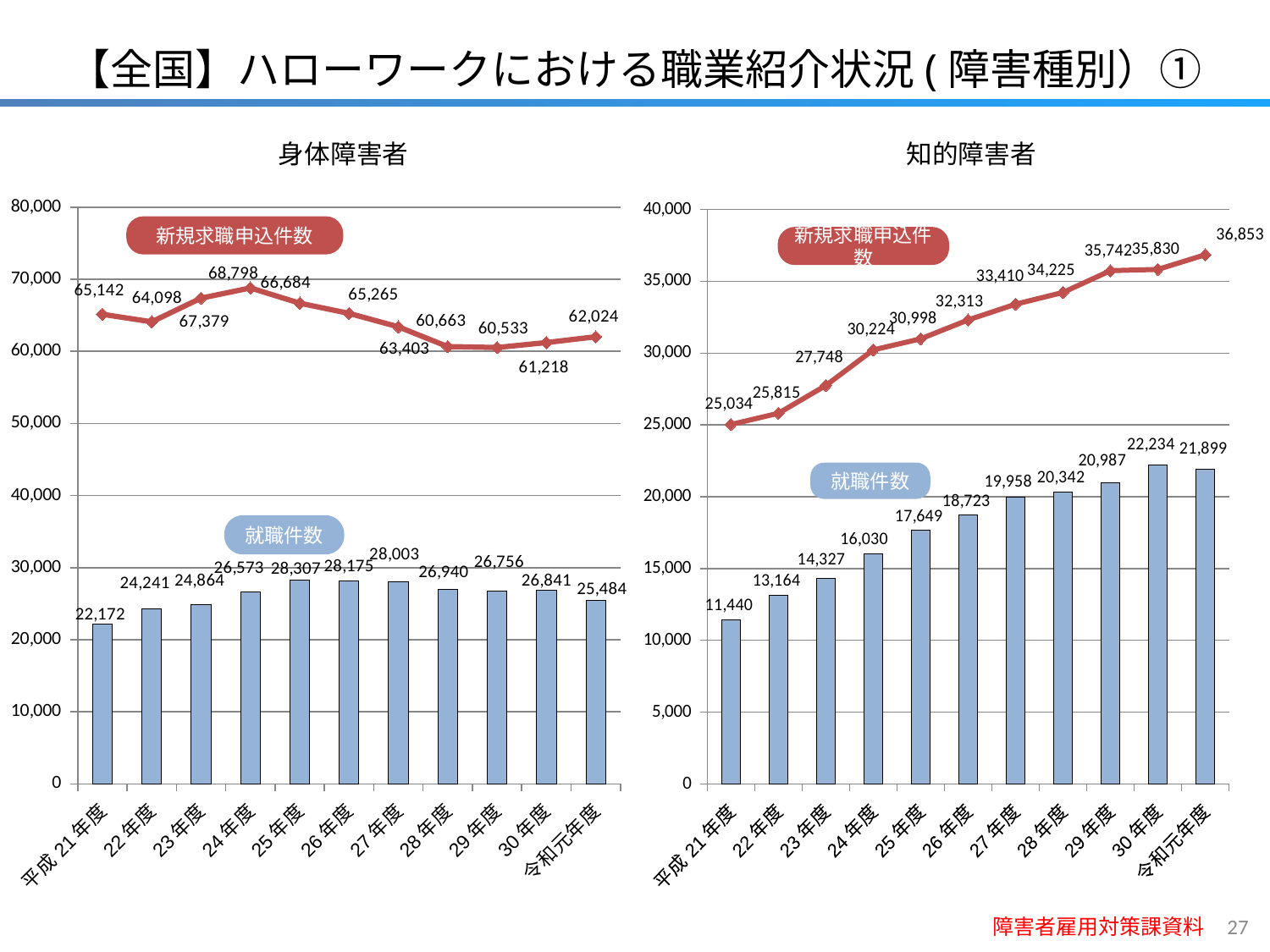
In the 知的障害者 chart, does the 新規求職申込件数 line generally rise or fall from 平成21年度 to 令和元年度? rise In the 知的障害者 chart, what is the 新規求職申込件数 value for 令和元年度? 36,853 In the 知的障害者 chart, what is the difference between the 就職件数 for 30年度 and 令和元年度? 335 In the 身体障害者 chart, is the 就職件数 for 25年度 larger or smaller than that for 26年度? larger In the 身体障害者 chart, what is the 就職件数 value for 令和元年度? 25,484 In the 身体障害者 chart, which fiscal year has the lowest 就職件数? 平成21年度 In the 知的障害者 chart, what is the 就職件数 value for 26年度? 18,723 In the 知的障害者 chart, which fiscal year has the highest 就職件数? 30年度 In the 身体障害者 chart, what is the difference between the 新規求職申込件数 for 24年度 and 29年度? 8,265 In the 身体障害者 chart, what is the 新規求職申込件数 value for 平成21年度? 65,142 How many fiscal years are shown on the x axis of the 身体障害者 chart? 11 In the 身体障害者 chart, which fiscal year has the highest 新規求職申込件数? 24年度